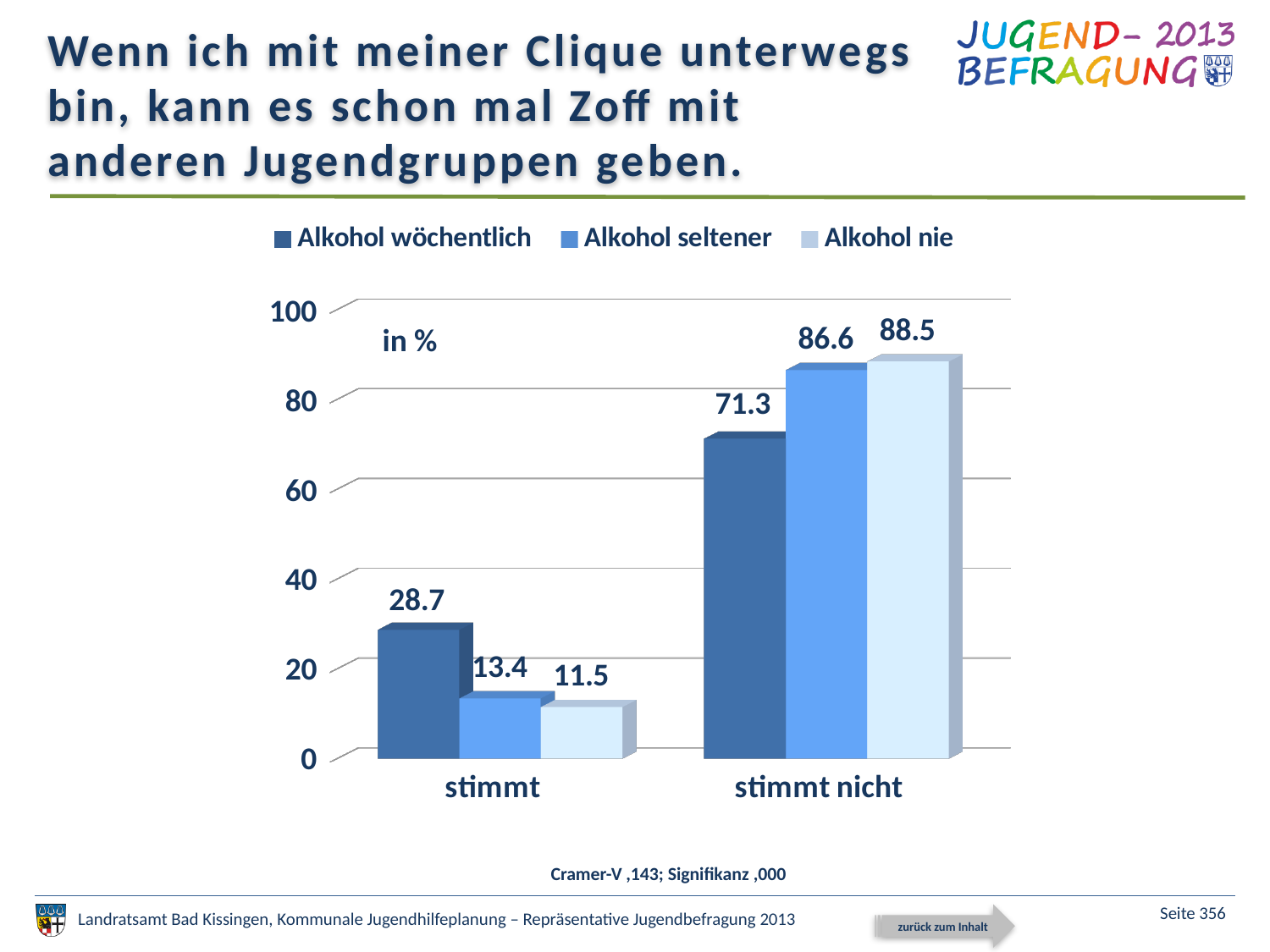
Which series has the highest value in the "stimmt nicht" category? Alkohol nie How many categories are shown on the x axis? 2 How many series does the legend list? 3 What is the value for "Alkohol seltener" in the "stimmt" category? 13.4 What kind of chart is shown on the slide? bar chart What unit is indicated inside the chart area? in % Which series has the lowest value in the "stimmt" category? Alkohol nie What is the value for "Alkohol nie" in the "stimmt nicht" category? 88.5 What is the difference between the "Alkohol wöchentlich" values for "stimmt nicht" and "stimmt"? 42.6 Is the value for "Alkohol wöchentlich" in "stimmt nicht" greater or less than 80? less Which is larger: the "Alkohol seltener" value for "stimmt" or the "Alkohol nie" value for "stimmt"? Alkohol seltener (13.4) What is the value for "Alkohol wöchentlich" in the "stimmt" category? 28.7